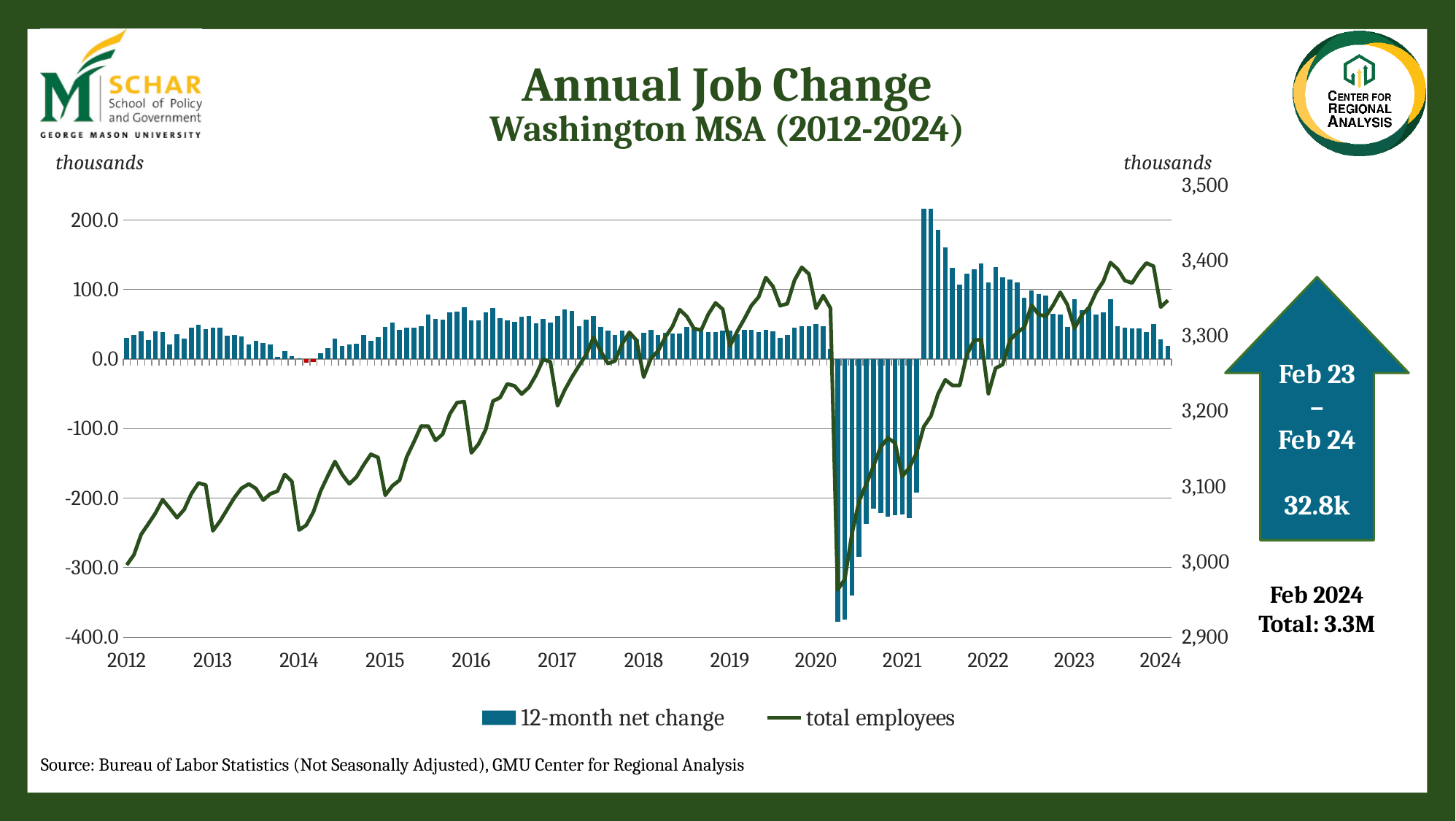
How many series does the legend list? 2 Is the lowest 12-month net change bar in 2020 greater or less than -300.0? less What kind of chart is shown on the slide? A combined bar and line chart Is the total employees value at the end of 2024 greater or less than 3,300? greater Is the highest 12-month net change bar in 2021 greater or less than 200.0? greater In which year do the 12-month net change bars reach their highest value? 2021 Does the total employees line rise or fall from 2012 to 2019? rise What is the job change from Feb 23 to Feb 24 shown in the arrow callout? 32.8k What is the total employment for Feb 2024 stated on the slide? 3.3M In which year do the 12-month net change bars reach their lowest value? 2020 What is the title of the chart? Annual Job Change What are the two series named in the legend? 12-month net change and total employees